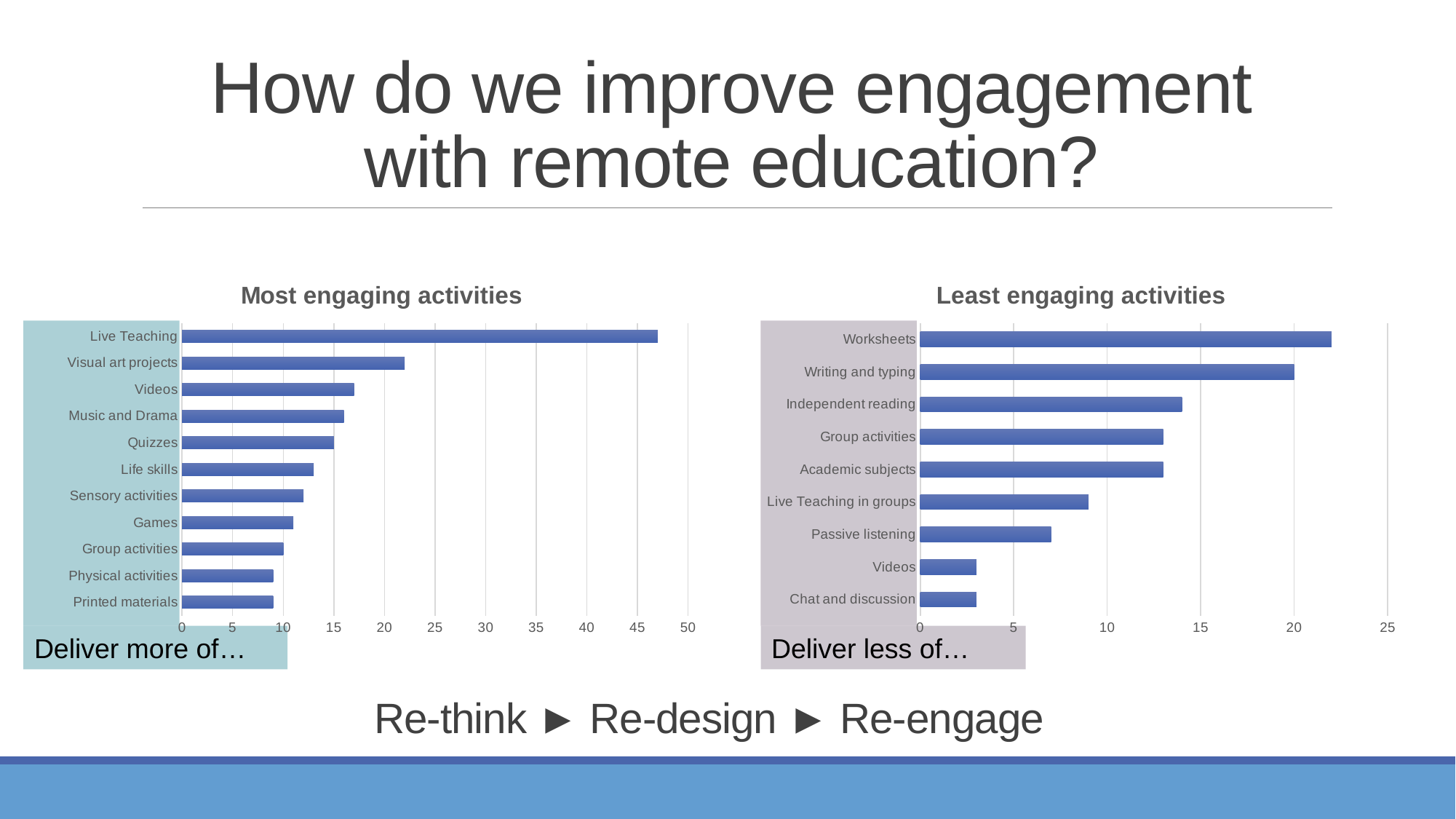
What type of chart is the 'Least engaging activities' chart? Bar chart On the 'Least engaging activities' chart, is the value for Writing and typing greater or less than 15? greater On the 'Most engaging activities' chart, which activity has the highest value? Live Teaching On the 'Most engaging activities' chart, is the value for Live Teaching greater or less than 45? greater On the 'Least engaging activities' chart, which activity has the highest value? Worksheets How many activities are listed on the 'Least engaging activities' chart? 9 On the 'Most engaging activities' chart, is the value for Games greater or less than 15? less On the 'Most engaging activities' chart, which is larger: Videos or Quizzes? Videos On the 'Least engaging activities' chart, which is larger: Independent reading or Live Teaching in groups? Independent reading How many activities are listed on the 'Most engaging activities' chart? 11